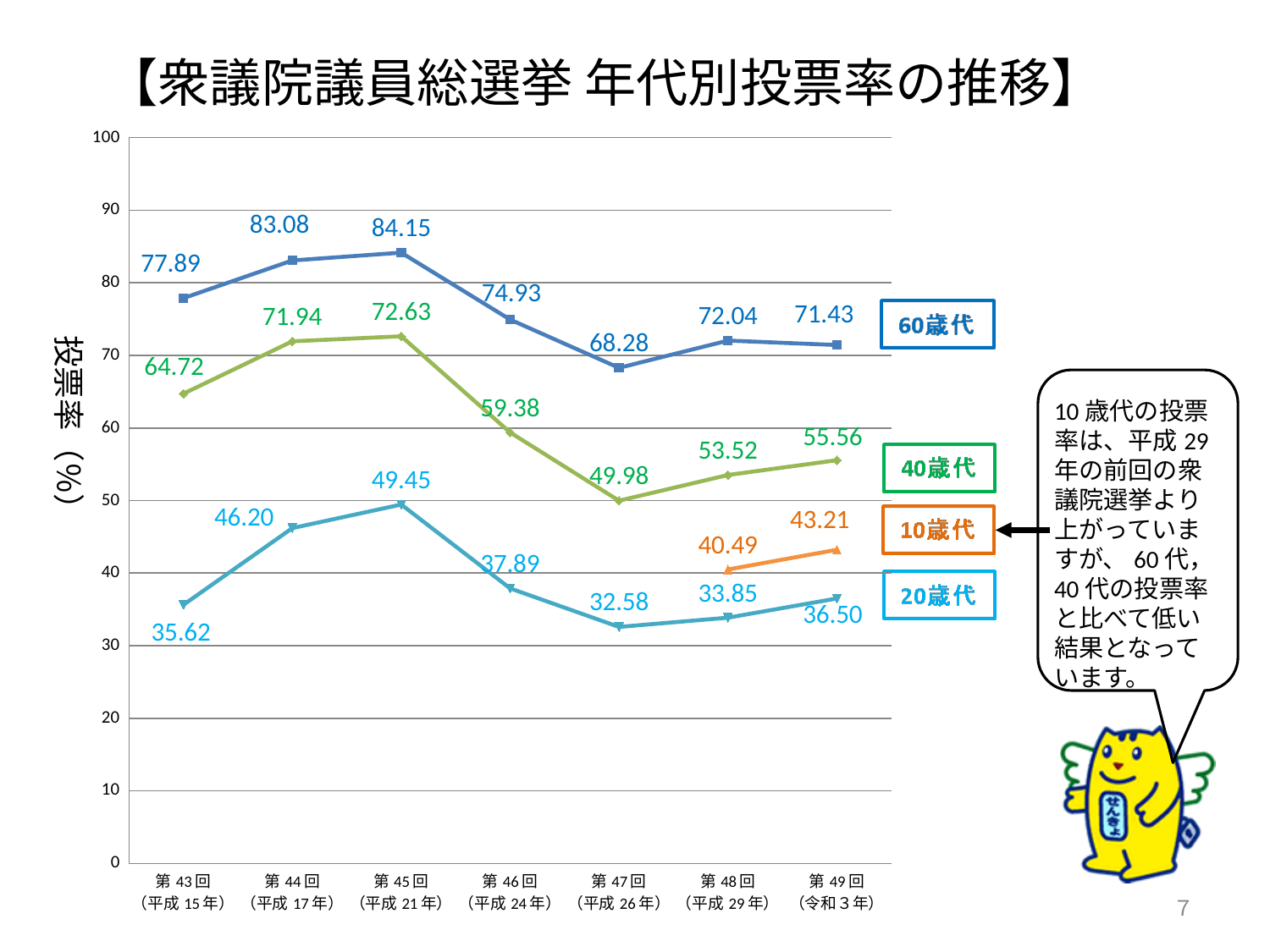
Did the voter turnout for 40歳代 rise or fall from 第45回 (平成21年) to 第47回 (平成26年)? fall What was the voter turnout for 60歳代 in 第45回 (平成21年)? 84.15 What was the voter turnout for 20歳代 in 第43回 (平成15年)? 35.62 Which had a higher voter turnout in 第48回 (平成29年): 10歳代 or 20歳代? 10歳代 In which election did 20歳代 have its lowest voter turnout? 第47回 (平成26年) How many elections are shown on the x axis? 7 What was the voter turnout for 40歳代 in 第47回 (平成26年)? 49.98 What is the difference between the 60歳代 and 20歳代 voter turnout in 第49回 (令和3年)? 34.93 What type of chart is shown on the slide? line chart What was the voter turnout for 10歳代 in 第49回 (令和3年)? 43.21 How many age-group series are plotted on the chart? 4 In which election did 60歳代 have its highest voter turnout? 第45回 (平成21年)